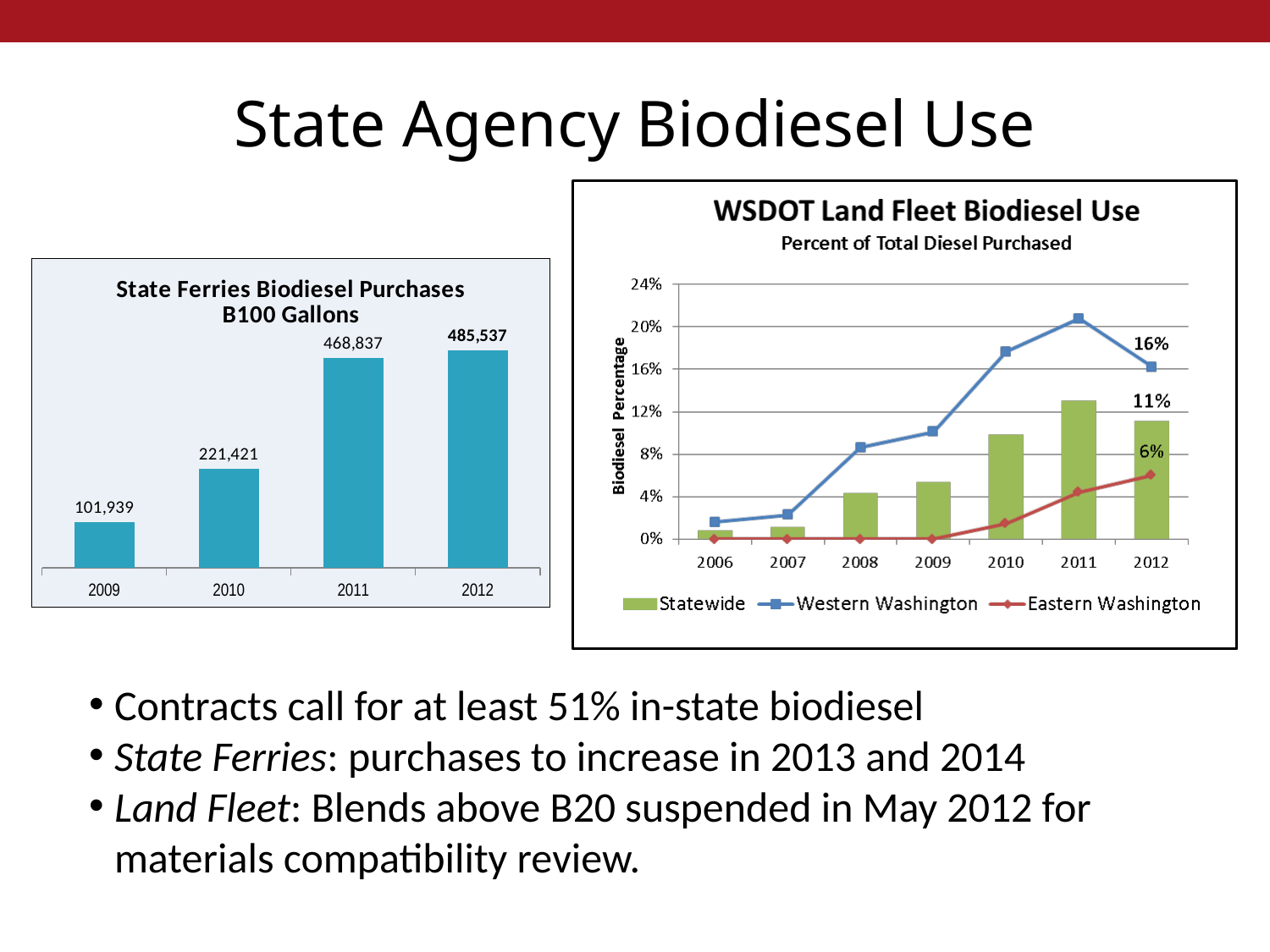
In the State Ferries Biodiesel Purchases chart, how many years are shown? 4 In the State Ferries Biodiesel Purchases chart, do purchases rise or fall from 2009 to 2012? rise In the WSDOT Land Fleet Biodiesel Use chart, what is the Western Washington value for 2012? 16% What type of chart is the State Ferries Biodiesel Purchases chart? bar chart In the WSDOT Land Fleet Biodiesel Use chart, how many series does the legend list? 3 In the State Ferries Biodiesel Purchases chart, which year had the lowest purchases? 2009 In the State Ferries Biodiesel Purchases chart, what was the value for 2010? 221,421 In the WSDOT Land Fleet Biodiesel Use chart, which series is higher in 2010, Western Washington or Eastern Washington? Western Washington In the WSDOT Land Fleet Biodiesel Use chart, what is the Eastern Washington value for 2012? 6% In the State Ferries Biodiesel Purchases chart, what is the difference between the 2012 and 2011 values? 16,700 In the State Ferries Biodiesel Purchases chart, which year had the highest purchases? 2012 In the WSDOT Land Fleet Biodiesel Use chart, is the Western Washington value for 2011 greater or less than 20%? greater